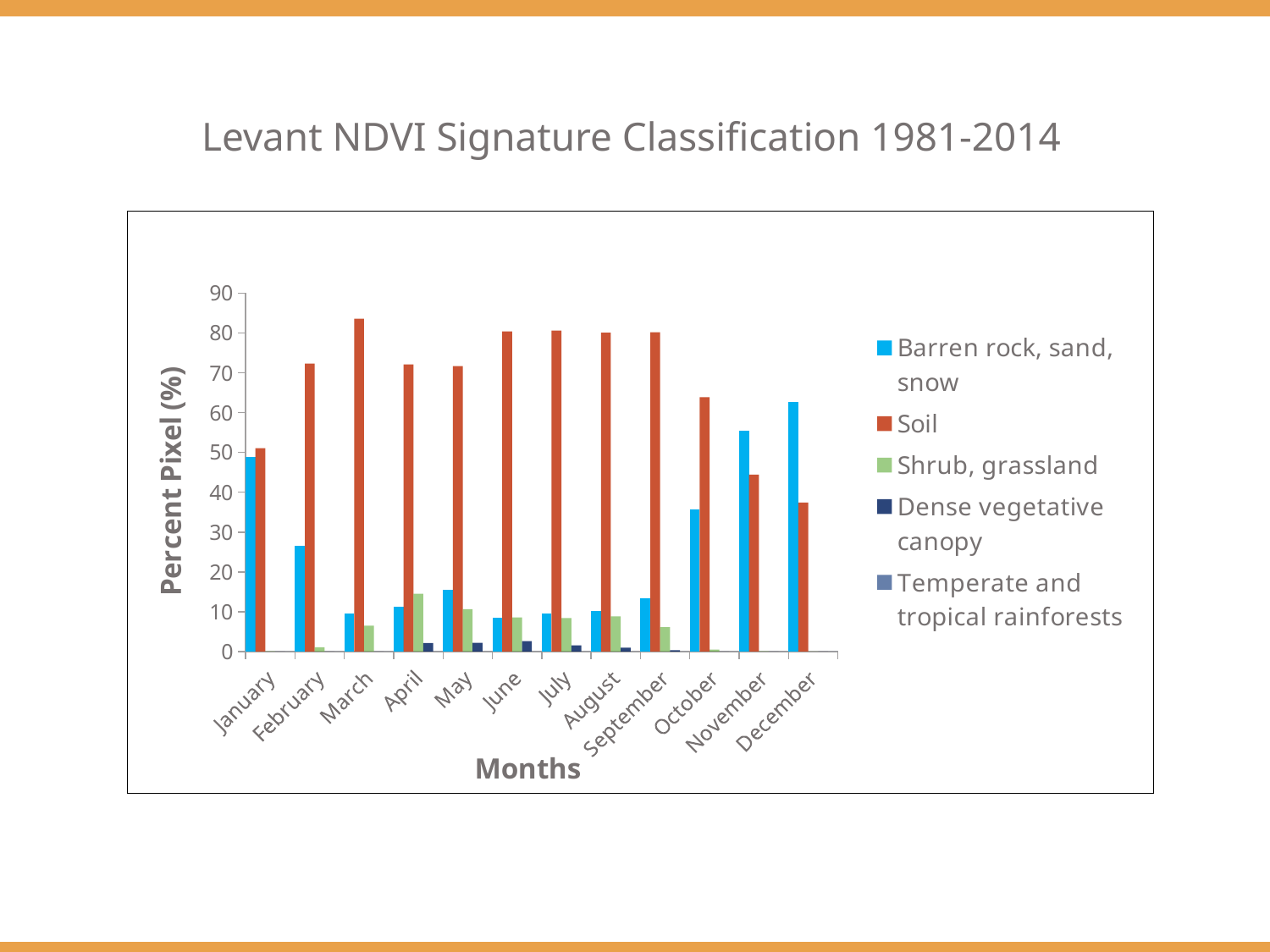
In which month is the Soil value highest? March Does the Soil value rise or fall from September to December? Fall In which month is the value for Barren rock, sand, snow highest? December What kind of chart is shown on the slide? Bar chart What is the title of the vertical axis? Percent Pixel (%) How many months are shown along the x axis? 12 In which month is the Soil value lowest? December In which month is the Shrub, grassland value highest? April How many series does the legend list? 5 Is the value for Barren rock, sand, snow in June greater or less than 10? less In December, which is larger: Barren rock, sand, snow or Soil? Barren rock, sand, snow Is the Soil value for March greater or less than 80? greater